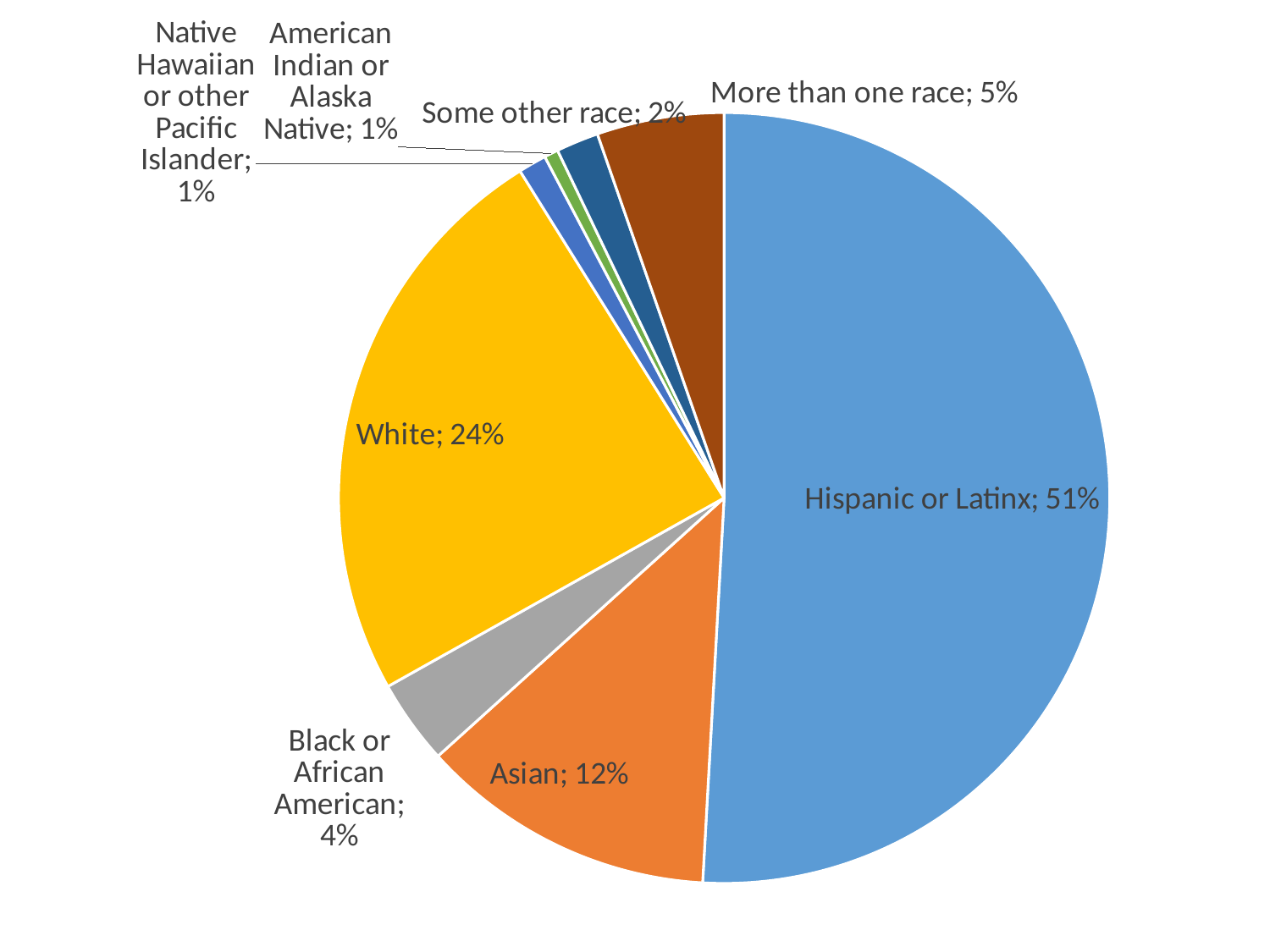
What percentage is shown for More than one race? 5% Which is larger, the share for Asian or the share for More than one race? Asian What percentage is shown for Asian? 12% What colour is the White slice? yellow What share of the pie is Hispanic or Latinx? 51% How many slices does the pie chart have? 8 What percentage is shown for Black or African American? 4% Which category has the largest slice of the pie? Hispanic or Latinx What percentage is shown for White? 24% What kind of chart is shown on the slide? pie chart What is the difference in percentage points between Hispanic or Latinx and White? 27 What percentage is shown for Some other race? 2%